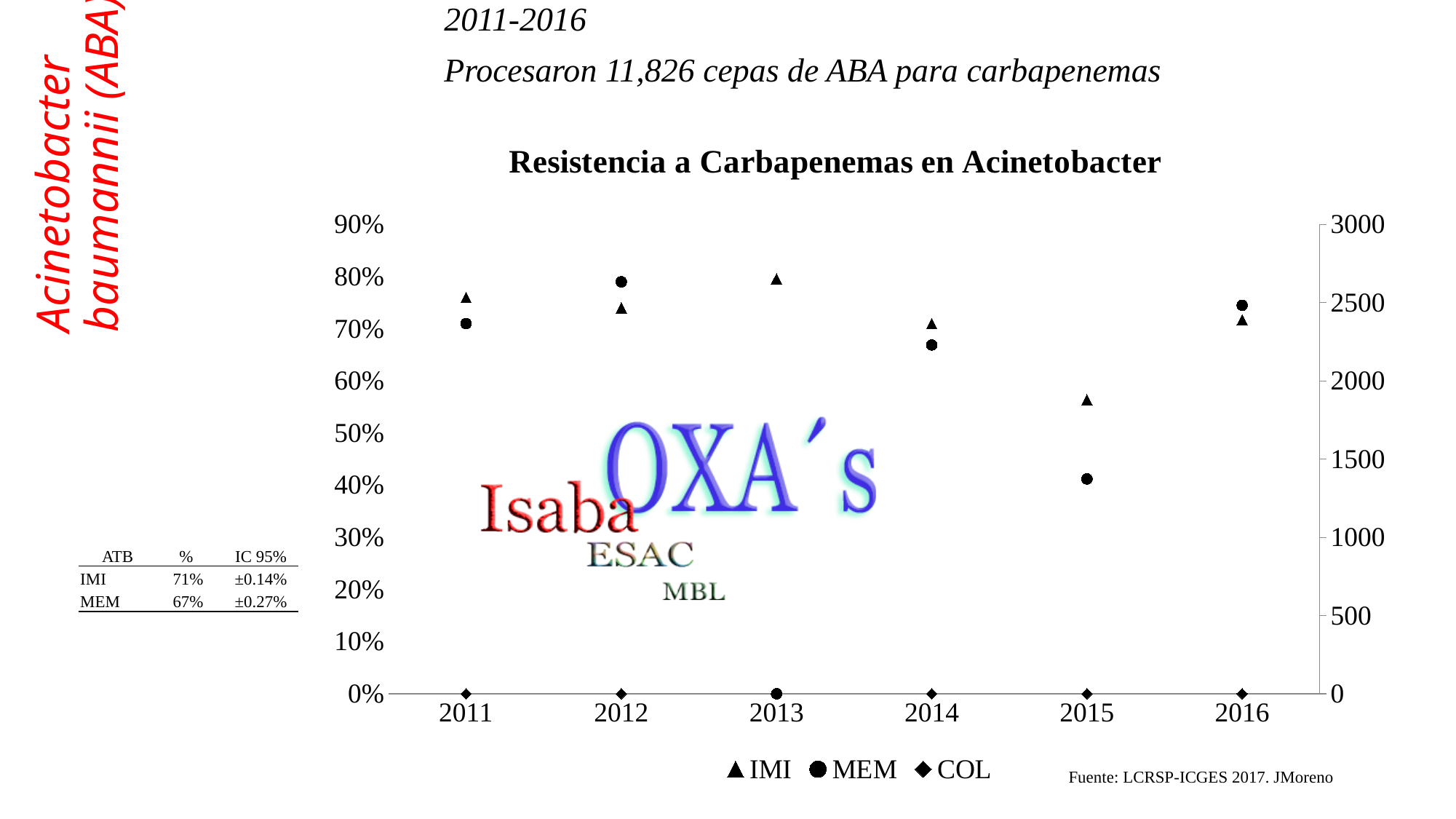
How many years are plotted along the x axis of the chart? 6 How many series does the chart legend list? 3 In 2012, which series has the larger value, IMI or MEM? MEM What kind of chart is shown on the slide? scatter chart Does the IMI series rise or fall from 2013 to 2015? fall Is the MEM value for 2015 greater or less than 50%? less In 2015, which series has the larger value, IMI or MEM? IMI Is the MEM value for 2012 greater or less than 70%? greater In which year is the IMI series at its lowest value? 2015 What is the title of the chart? Resistencia a Carbapenemas en Acinetobacter Is the IMI value for 2015 greater or less than 60%? less